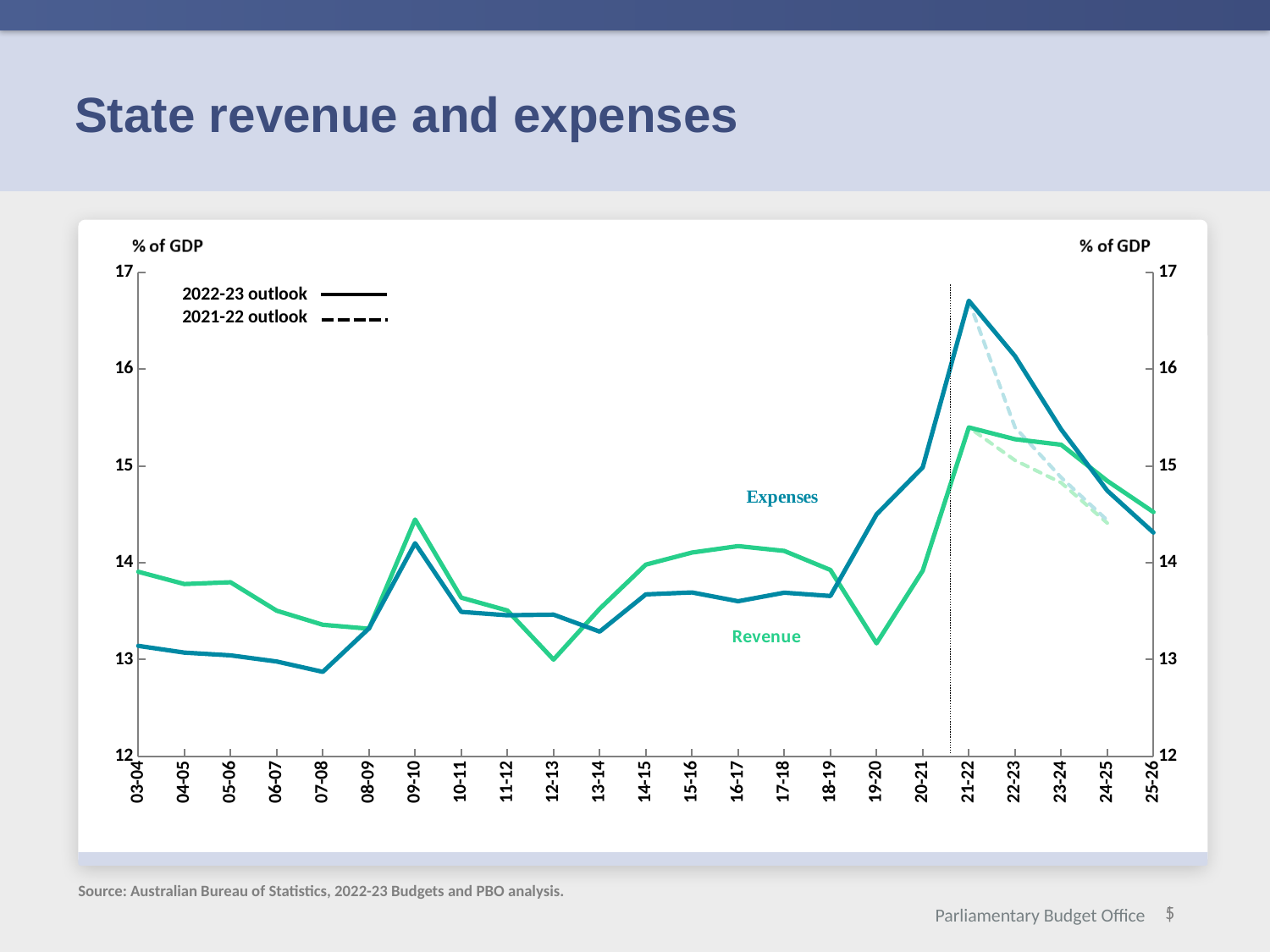
Which line style does the legend use for the 2021-22 outlook? Dashed line How many financial years are shown along the x axis of the chart? 23 What unit is shown on the y axis of the chart? % of GDP Is the value for Revenue in 09-10 greater or less than 14? greater What kind of chart is shown on the slide? Line chart In which year does the Expenses line reach its lowest value? 07-08 In 21-22, which is higher, Expenses or Revenue? Expenses Do Expenses rise or fall from 21-22 to 25-26? fall In 16-17, which is higher, Expenses or Revenue? Revenue In which year does the Expenses line reach its highest value? 21-22 Is the value for Revenue in 19-20 greater or less than 14? less Is the value for Expenses in 21-22 greater or less than 16? greater